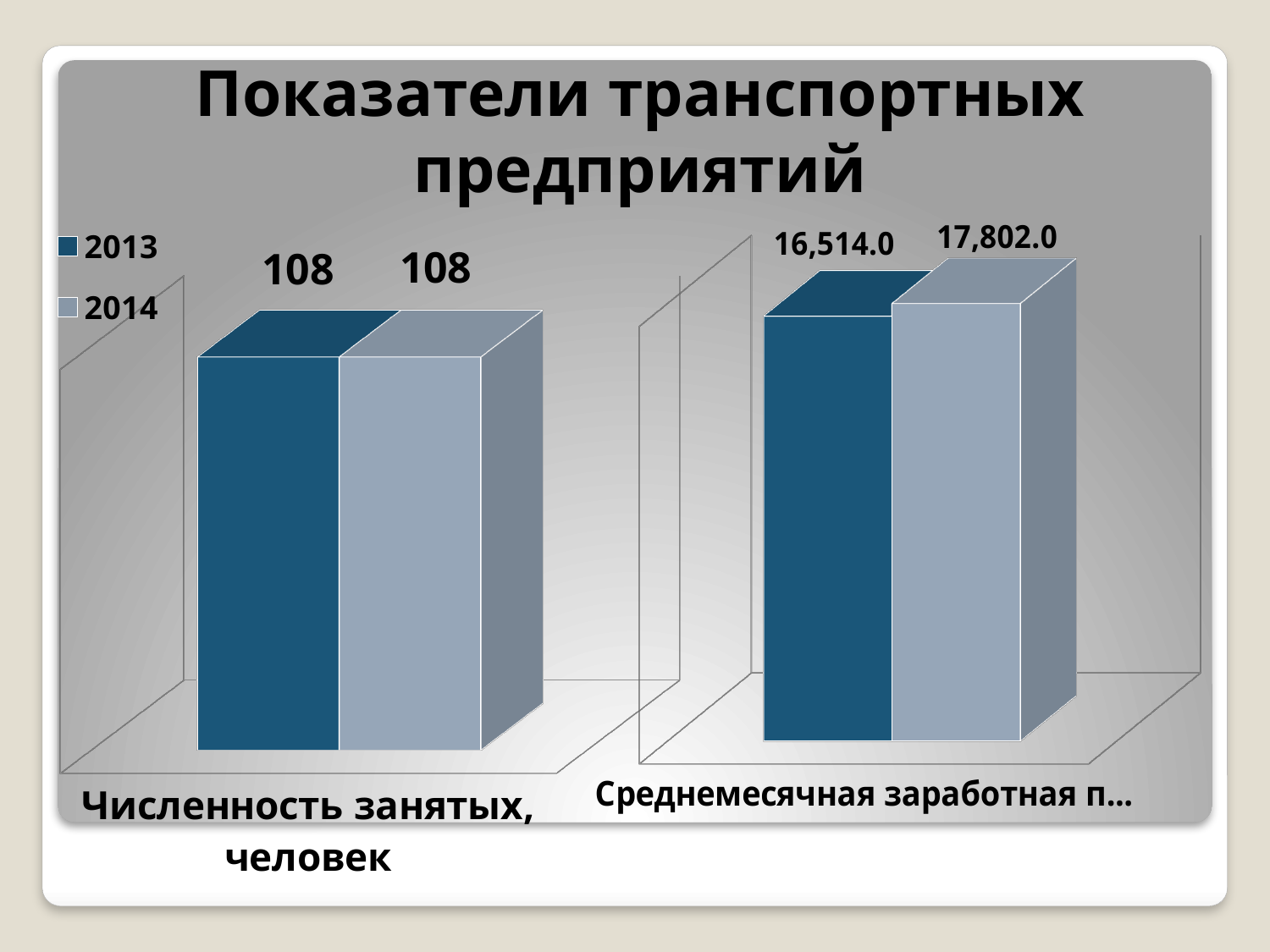
In the left chart (Численность занятых, человек), what is the value for 2014? 108 In the right chart (Среднемесячная заработная п...), what is the value for 2014? 17,802.0 In the right chart, what is the difference between the 2014 and 2013 values? 1,288.0 In the right chart (Среднемесячная заработная п...), what is the value for 2013? 16,514.0 What is the title of the slide? Показатели транспортных предприятий How many series does the legend list? 2 In the right chart, which year has the larger value, 2013 or 2014? 2014 In the right chart, does the value rise or fall from 2013 to 2014? rise In the left chart (Численность занятых, человек), what is the value for 2013? 108 How many bars are plotted in the left chart? 2 In the left chart, is the 2014 value larger than, smaller than, or the same as the 2013 value? the same What kind of chart is shown on the slide? bar chart